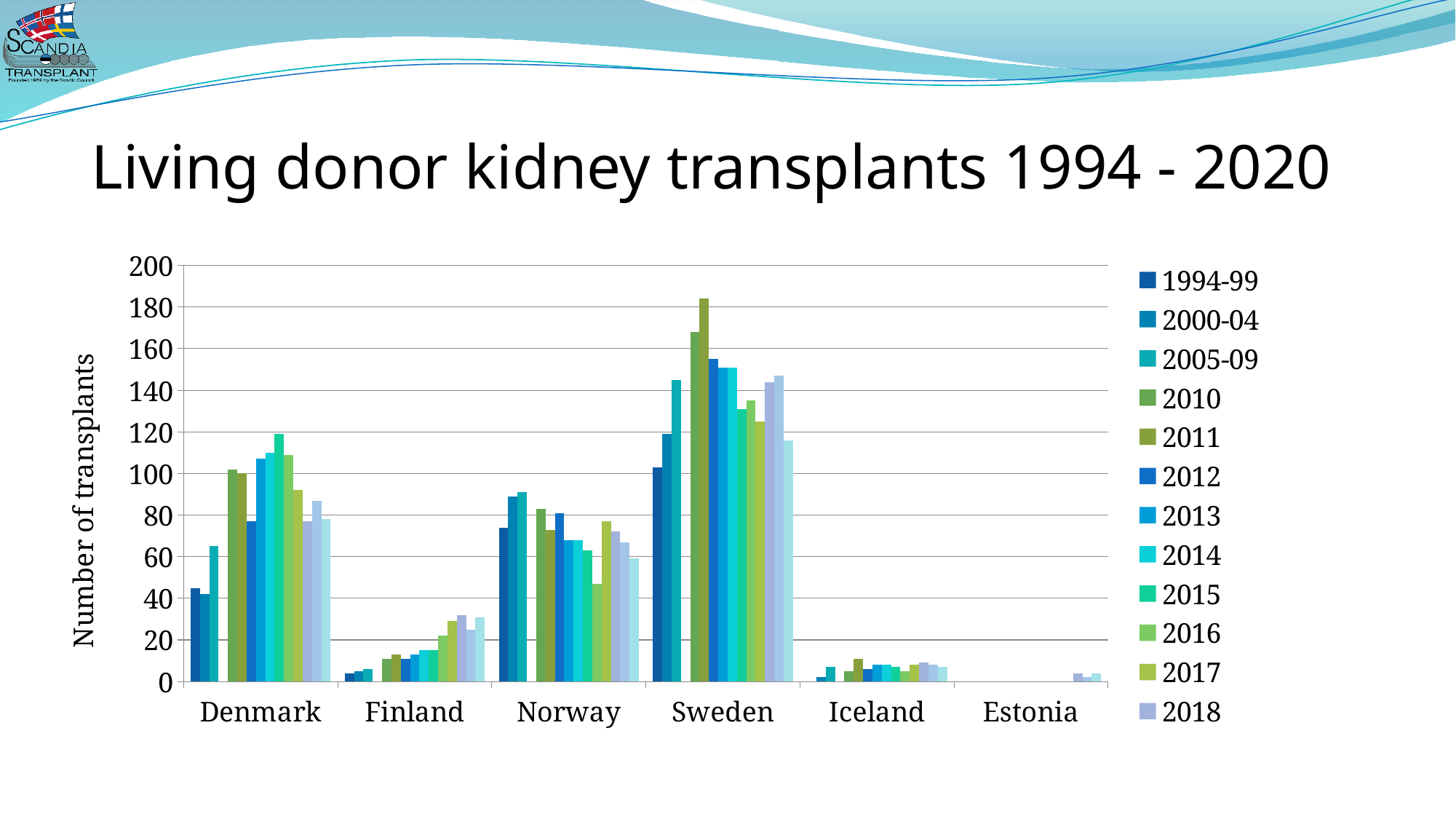
What is the label of the y axis? Number of transplants Which country has the lowest number of living donor kidney transplants in the chart? Estonia Is the value for Finland in 2017 greater or less than 40? less Is the value for Sweden in 2010 greater or less than 160? greater Which country has the highest number of living donor kidney transplants in the chart? Sweden What kind of chart is shown on the slide? bar chart How many countries are shown on the x axis of the chart? 6 Is the value for Denmark in 2014 greater or less than 100? greater Which is larger, the value for Sweden in 2005-09 or the value for Norway in 2005-09? Sweden in 2005-09 Which is larger, the value for Denmark in 2010 or the value for Finland in 2010? Denmark in 2010 What is the title of the chart on the slide? Living donor kidney transplants 1994 - 2020